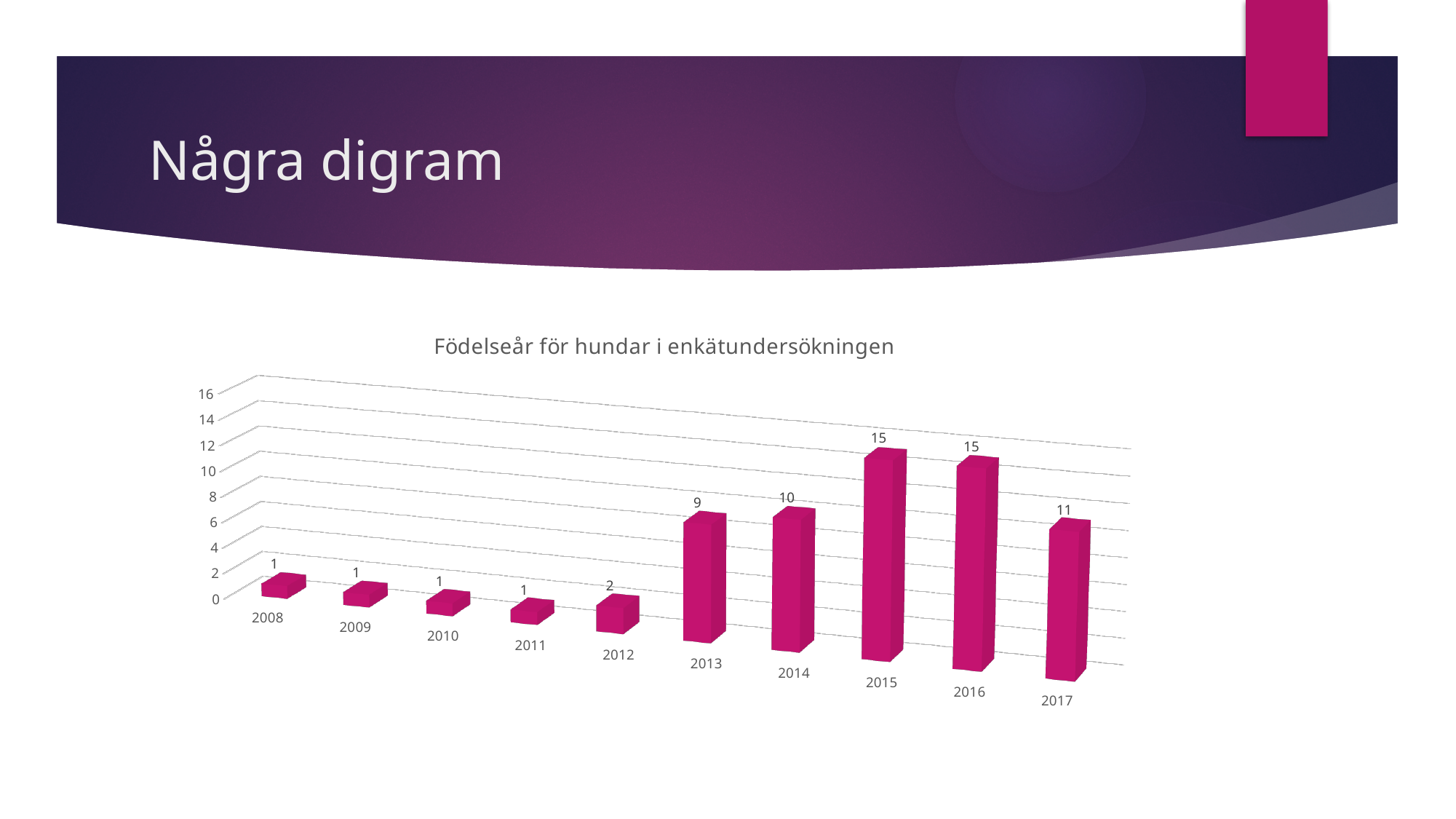
Is the value for 2015 greater or less than 12? greater What is the value for 2014? 10 What is the value for 2012? 2 What is the value for 2017? 11 What is the difference between the values for 2016 and 2017? 4 What kind of chart is shown on the slide? bar chart What is the value for 2013? 9 What is the difference between the values for 2014 and 2012? 8 What is the title of the chart? Födelseår för hundar i enkätundersökningen How many years are shown on the x axis? 10 What is the highest value shown in the chart? 15 Which is larger, the value for 2013 or the value for 2014? 2014